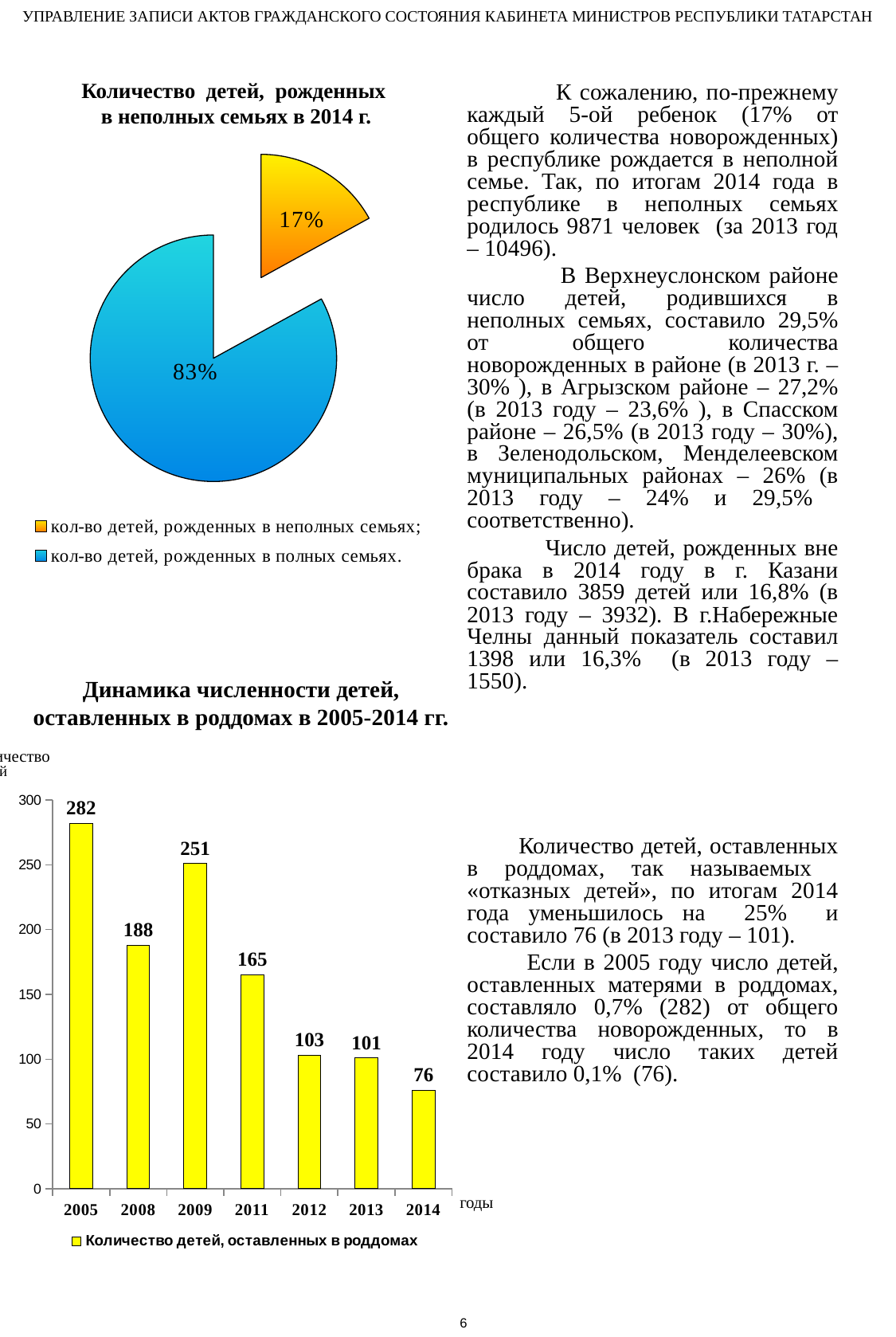
What type of chart is the top-left chart titled 'Количество детей, рожденных в неполных семьях в 2014 г.'? pie chart How many years (bars) are shown in the bar chart 'Динамика численности детей, оставленных в роддомах в 2005-2014 гг.'? 7 In the bar chart 'Динамика численности детей, оставленных в роддомах в 2005-2014 гг.', which year has the lowest value? 2014 In the bar chart 'Динамика численности детей, оставленных в роддомах в 2005-2014 гг.', what is the value for 2005? 282 In the bar chart 'Динамика численности детей, оставленных в роддомах в 2005-2014 гг.', which is larger, the value for 2008 or the value for 2009? 2009 In the bar chart 'Динамика численности детей, оставленных в роддомах в 2005-2014 гг.', which year has the highest value? 2005 How many entries does the legend of the top-left pie chart list? 2 In the bar chart 'Динамика численности детей, оставленных в роддомах в 2005-2014 гг.', what is the value for 2014? 76 In the pie chart at the top left, what share of children were born in single-parent families (неполных семьях)? 17% In the pie chart at the top left, what share of children were born in two-parent families (полных семьях)? 83% In the bar chart 'Динамика численности детей, оставленных в роддомах в 2005-2014 гг.', what is the difference between the values for 2009 and 2011? 86 What type of chart is the bottom-left chart titled 'Динамика численности детей, оставленных в роддомах в 2005-2014 гг.'? bar chart